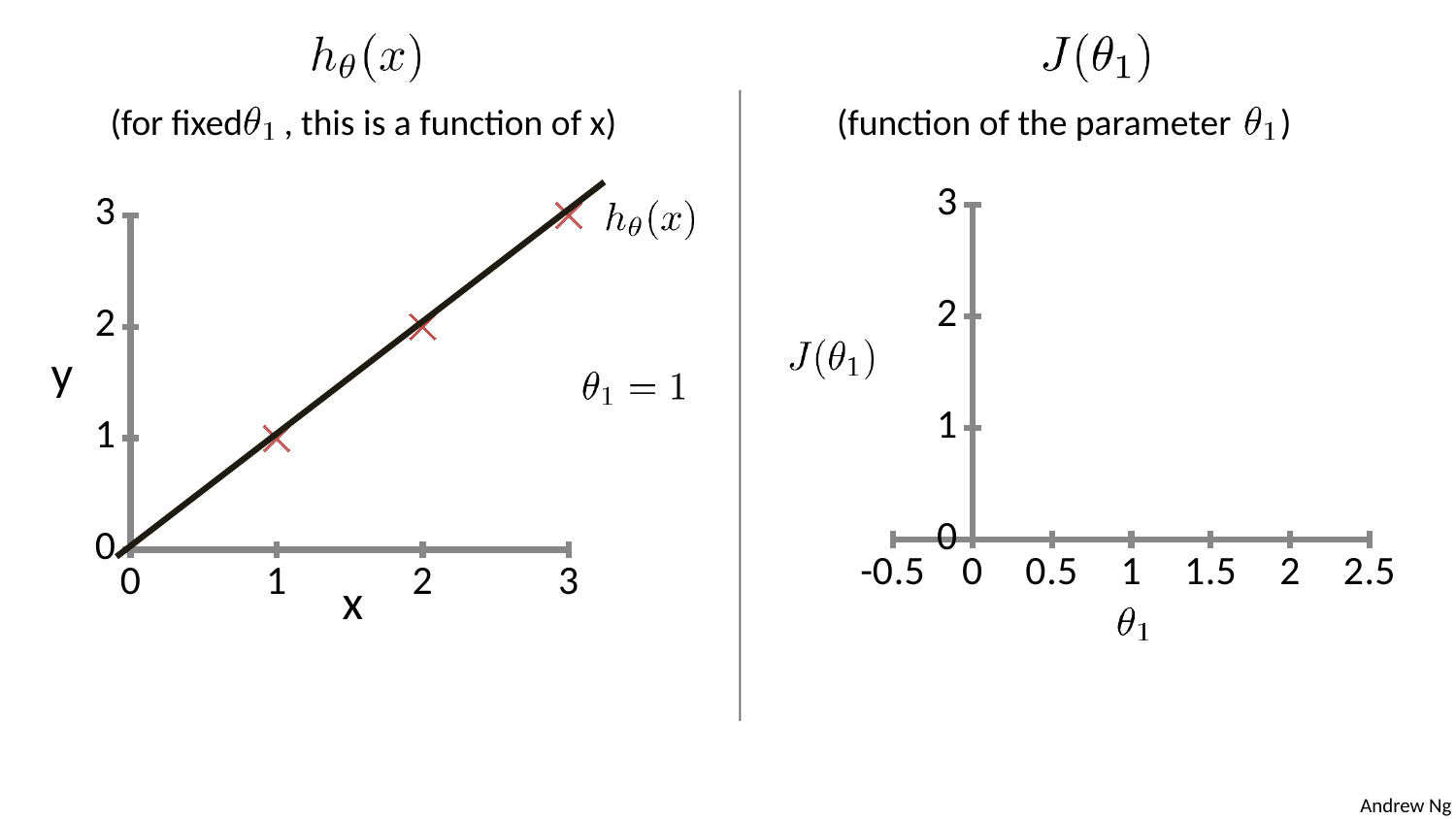
On the left chart h_θ(x), what is the y value of the data point at x = 3? 3 On the left chart h_θ(x), what value of θ1 is stated for the plotted line? θ1 = 1 On the left chart h_θ(x), what is the difference between the y values at x = 3 and x = 1? 2 On the left chart h_θ(x), what is the y value of the data point at x = 1? 1 On the left chart h_θ(x), how many data points (red crosses) are plotted? 3 On the left chart h_θ(x), which x value has the lowest y value? 1 On the right chart J(θ1), what is the largest value labelled on the horizontal axis? 2.5 On the left chart h_θ(x), what is the y value of the data point at x = 2? 2 On the left chart h_θ(x), is the y value at x = 3 greater or less than 2? greater On the left chart h_θ(x), do the y values rise or fall as x increases? rise On the left chart h_θ(x), which x value has the highest y value? 3 On the right chart J(θ1), what is the smallest value labelled on the horizontal axis? -0.5